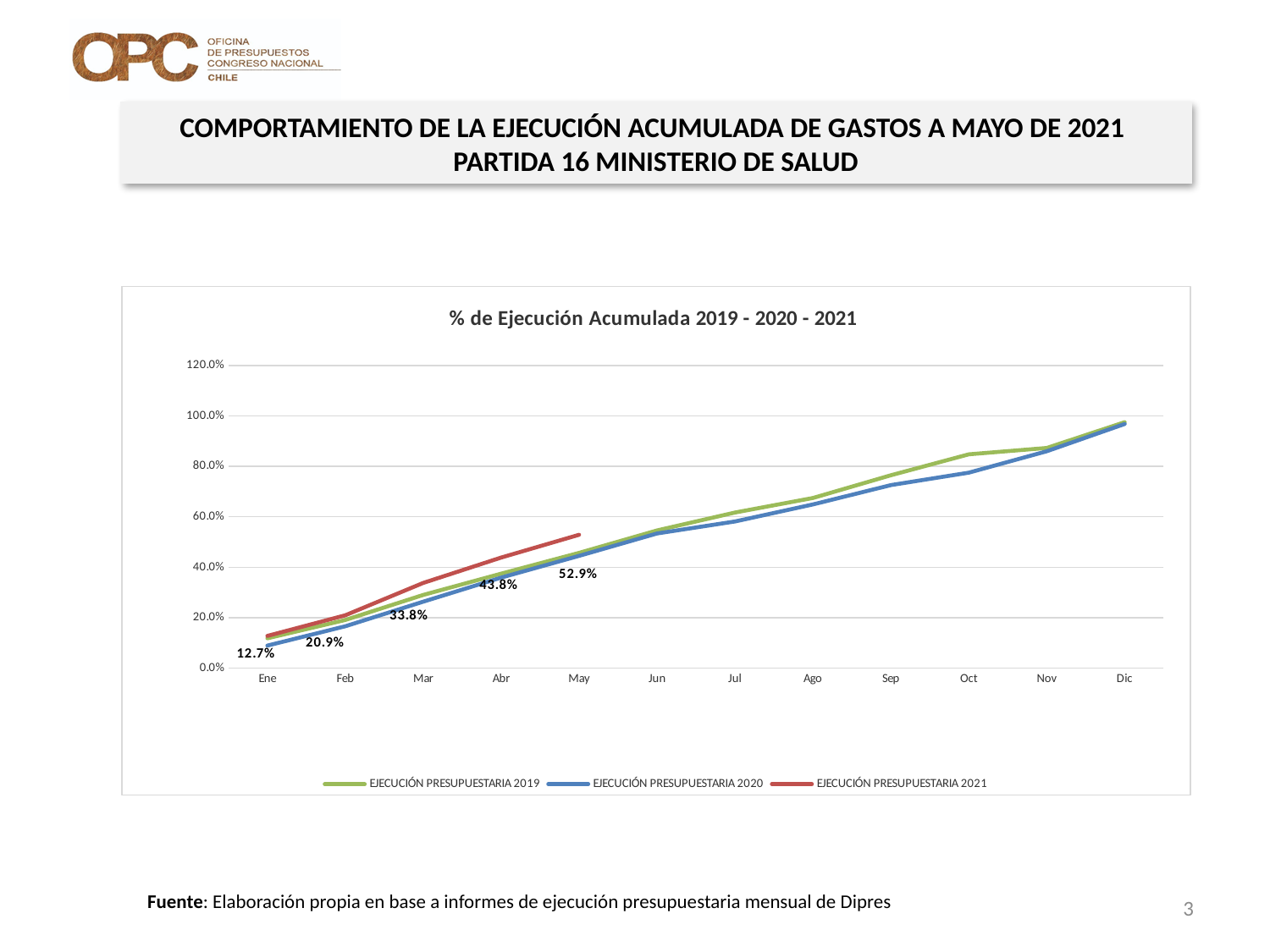
What is the value of EJECUCIÓN PRESUPUESTARIA 2021 in May? 52.9% How many months are shown along the x axis? 12 What is the value of EJECUCIÓN PRESUPUESTARIA 2021 in Ene? 12.7% What is the title of the chart? % de Ejecución Acumulada 2019 - 2020 - 2021 How many series does the legend list? 3 What is the difference between the 2021 values for May and Abr? 9.1% What is the value of EJECUCIÓN PRESUPUESTARIA 2021 in Mar? 33.8% Do the values of EJECUCIÓN PRESUPUESTARIA 2020 rise or fall from Ene to Dic? rise Is the value for EJECUCIÓN PRESUPUESTARIA 2020 in Sep greater or less than 80.0%? less What kind of chart is shown on the slide? line chart In May, which series has the higher value: EJECUCIÓN PRESUPUESTARIA 2021 or EJECUCIÓN PRESUPUESTARIA 2020? EJECUCIÓN PRESUPUESTARIA 2021 What is the difference between the 2021 values for Mar and Feb? 12.9%